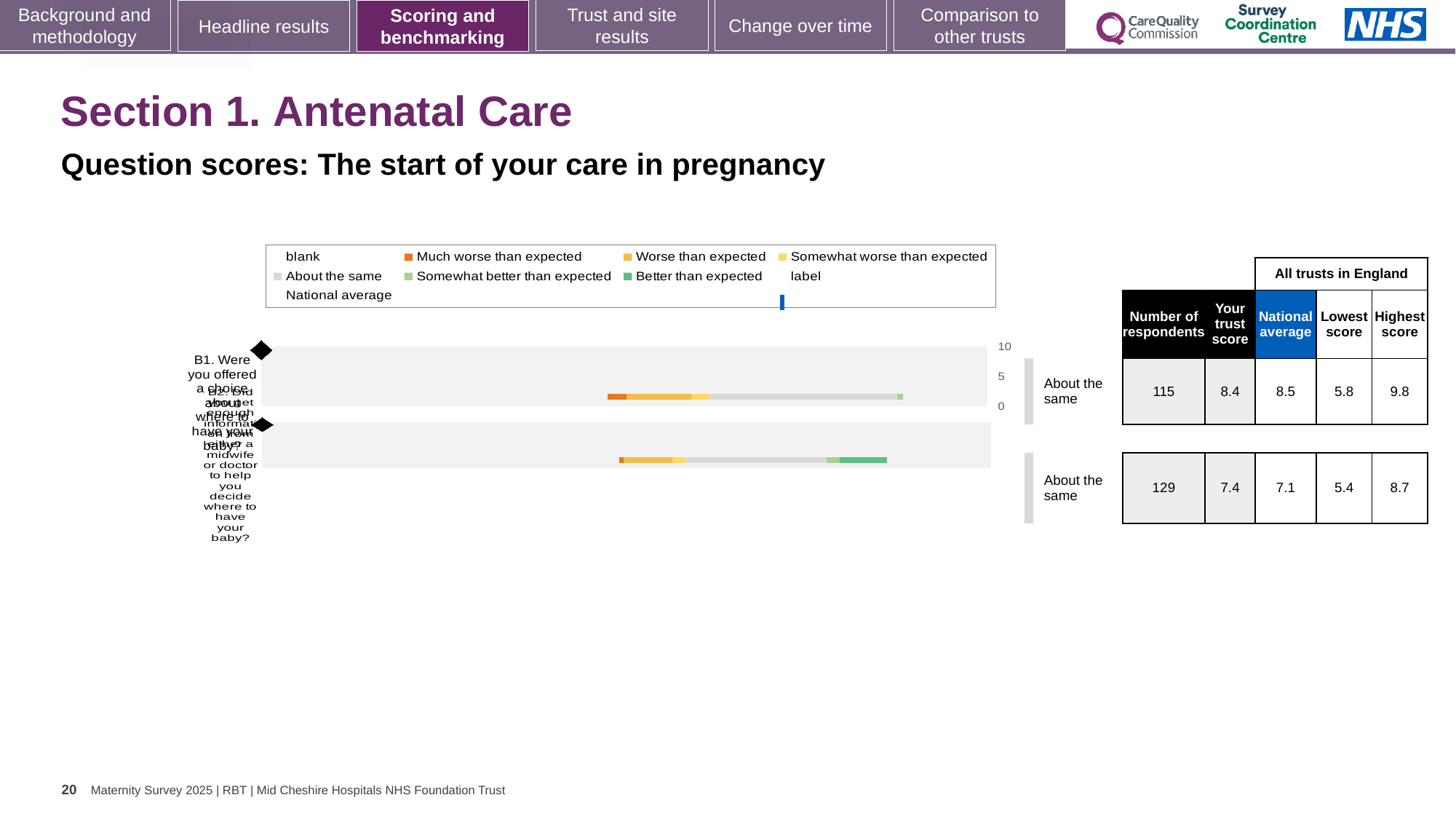
What is the lowest score among all trusts in England for question B1? 5.8 What is the highest score among all trusts in England for question B2? 8.7 What is the difference between the highest and lowest scores for question B1? 4.0 How many survey questions are plotted in the chart? 2 Which question has more respondents, B1 or B2? B2 What benchmark category is shown next to question B1's bar? About the same What kind of chart is shown on the slide? bar chart What is the national average for question B1? 8.5 How many respondents answered question B2? 129 For question B1, which is larger: the trust score or the national average? National average What is the difference between the trust score and the national average for question B2? 0.3 What is the 'Your trust score' for question B1 (Were you offered a choice about where to have your baby?)? 8.4